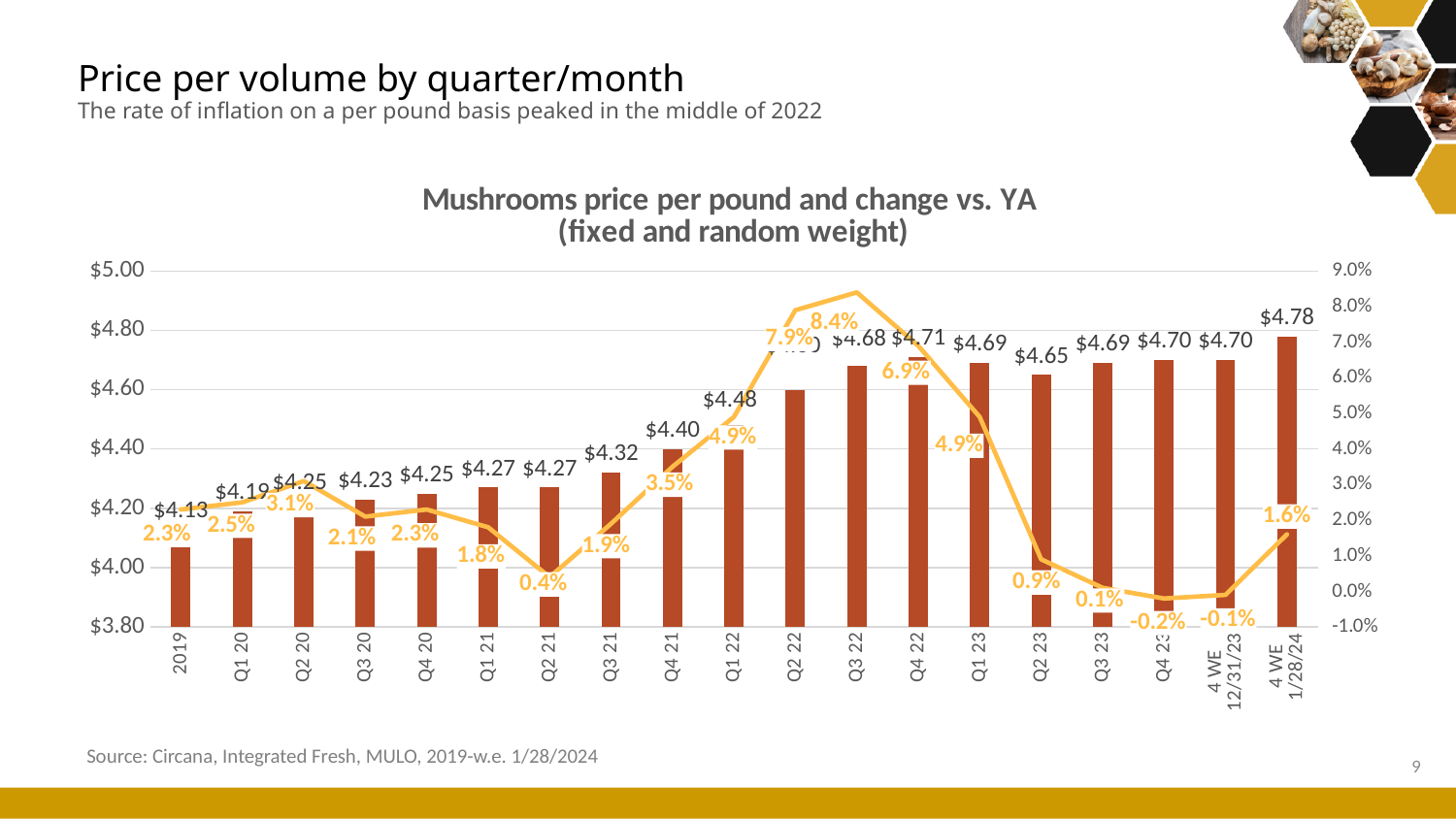
What is the change vs. YA shown for Q3 22? 8.4% Which period has the lowest change vs. YA? Q4 23 Is the price per pound for Q2 22 greater or less than $4.40? greater Which period has the lowest price per pound? 2019 Which has the higher price per pound, Q4 22 or Q2 23? Q4 22 What is the title of the chart? Mushrooms price per pound and change vs. YA (fixed and random weight) What kind of chart is this? Combined bar and line chart Which period has the highest price per pound? 4 WE 1/28/24 How many periods are shown on the x axis? 19 What is the mushrooms price per pound for Q1 22? $4.48 What is the price per pound for the 4 WE 1/28/24 period? $4.78 What is the difference in price per pound between 4 WE 1/28/24 and 2019? $0.65